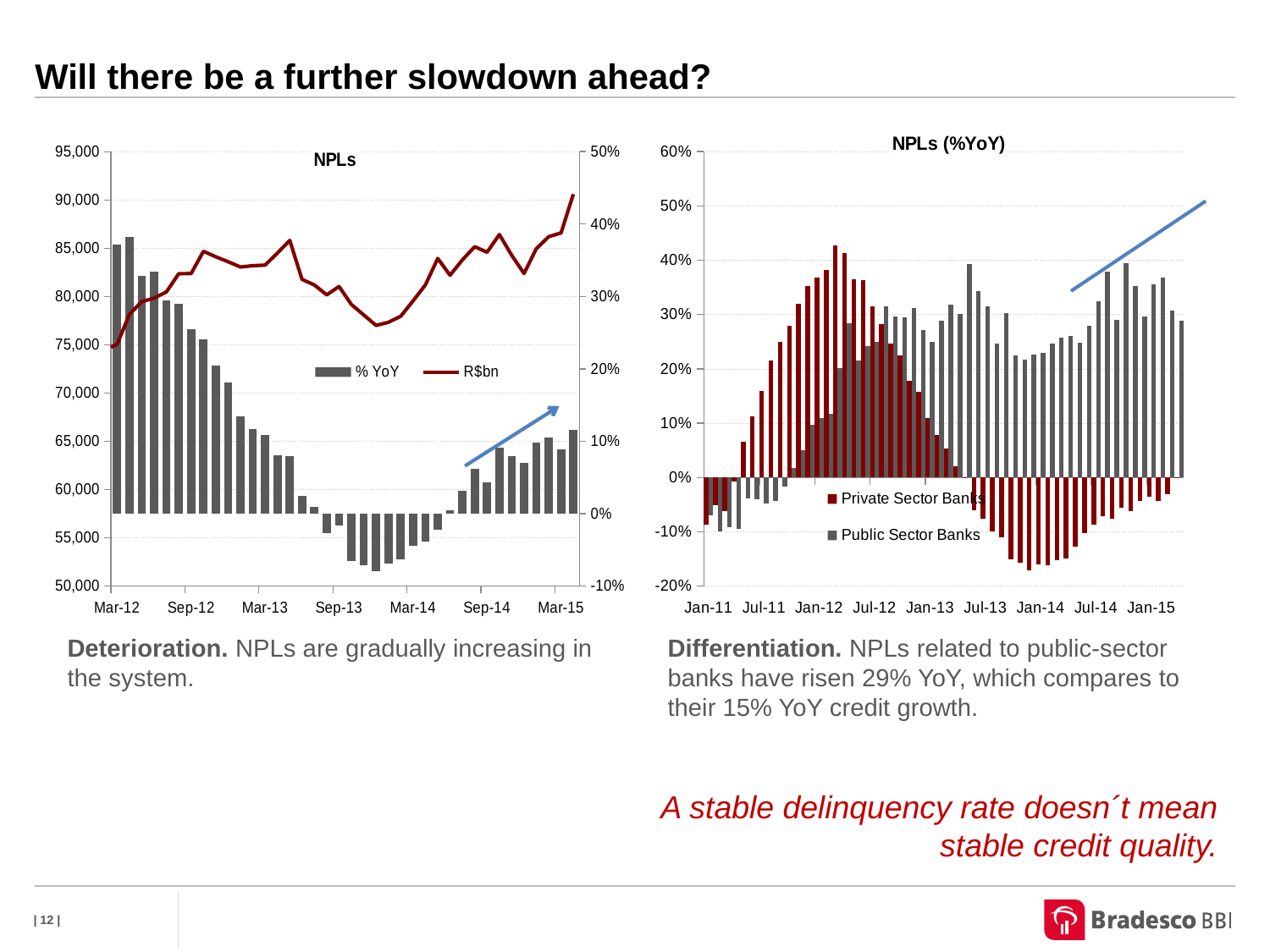
What kind of chart is the left chart titled "NPLs"? A combined bar and line chart In the right chart titled "NPLs (%YoY)", is the Private Sector Banks value at Jan-12 greater or less than 30%? greater In the left chart titled "NPLs", is the R$bn value at Mar-15 greater or less than 85,000? greater In the left chart titled "NPLs", how many series does the legend list? 2 In the left chart titled "NPLs", is the R$bn value at Mar-12 greater or less than 80,000? less In the left chart titled "NPLs", does the R$bn line rise or fall between Sep-14 and Mar-15? rise In the left chart titled "NPLs", do the % YoY bars rise or fall between Mar-12 and Sep-13? fall In the right chart titled "NPLs (%YoY)", what are the two series listed in the legend? Private Sector Banks and Public Sector Banks In the right chart titled "NPLs (%YoY)", which series has the higher value at Jan-15, Private Sector Banks or Public Sector Banks? Public Sector Banks